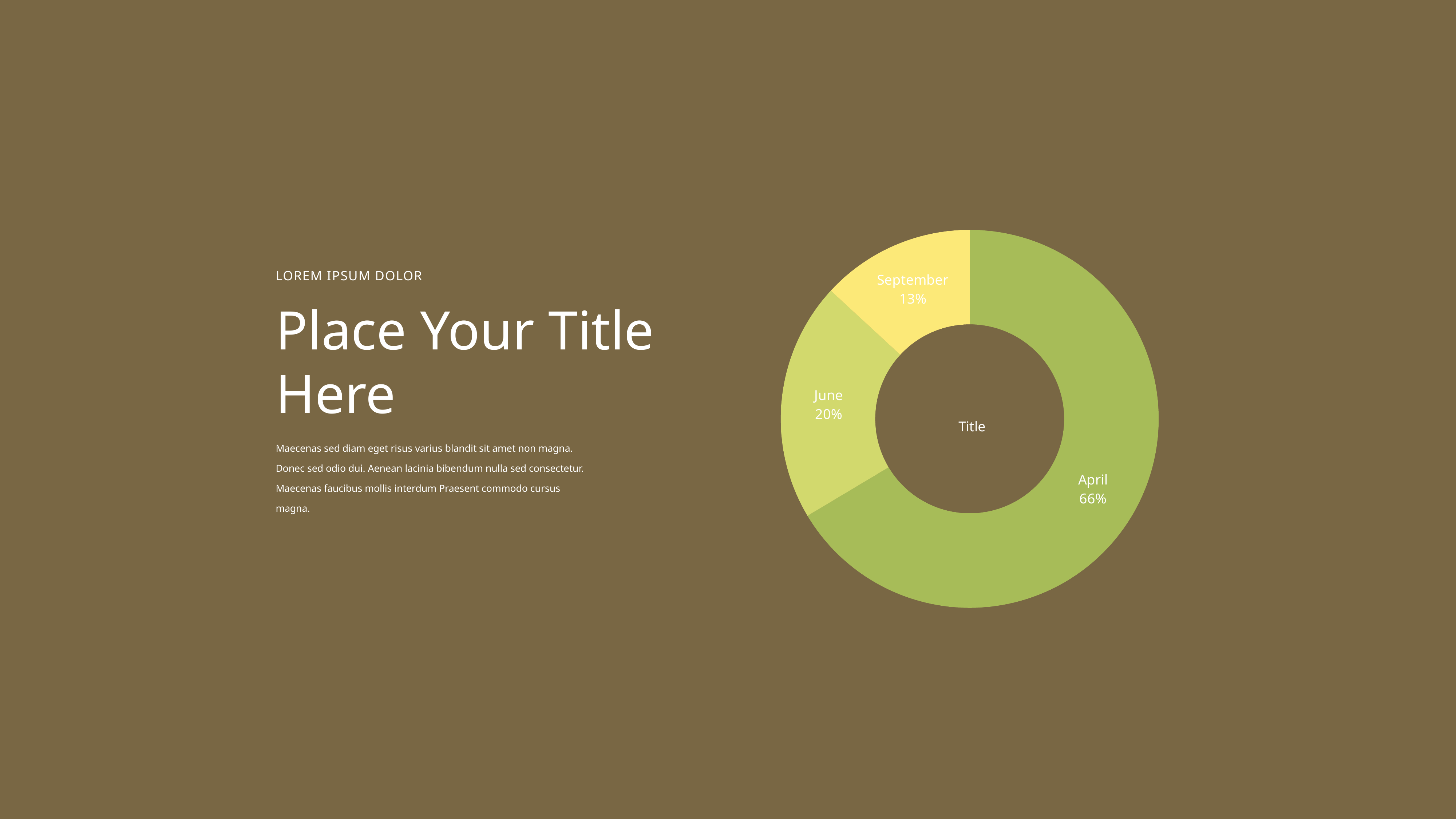
What text appears in the centre of the doughnut chart? Title What colour is the September slice in the doughnut chart? Yellow Which category has the largest share in the doughnut chart? April What kind of chart is shown on the slide? Doughnut chart How many slices does the doughnut chart have? 3 Which slice is larger, June or September? June What is the difference in percentage points between the April and June slices? 46 What is the difference in percentage points between the June and September slices? 7 What percentage does the April slice represent in the doughnut chart? 66% What percentage does the June slice represent in the doughnut chart? 20% Which category has the smallest share in the doughnut chart? September What percentage does the September slice represent in the doughnut chart? 13%